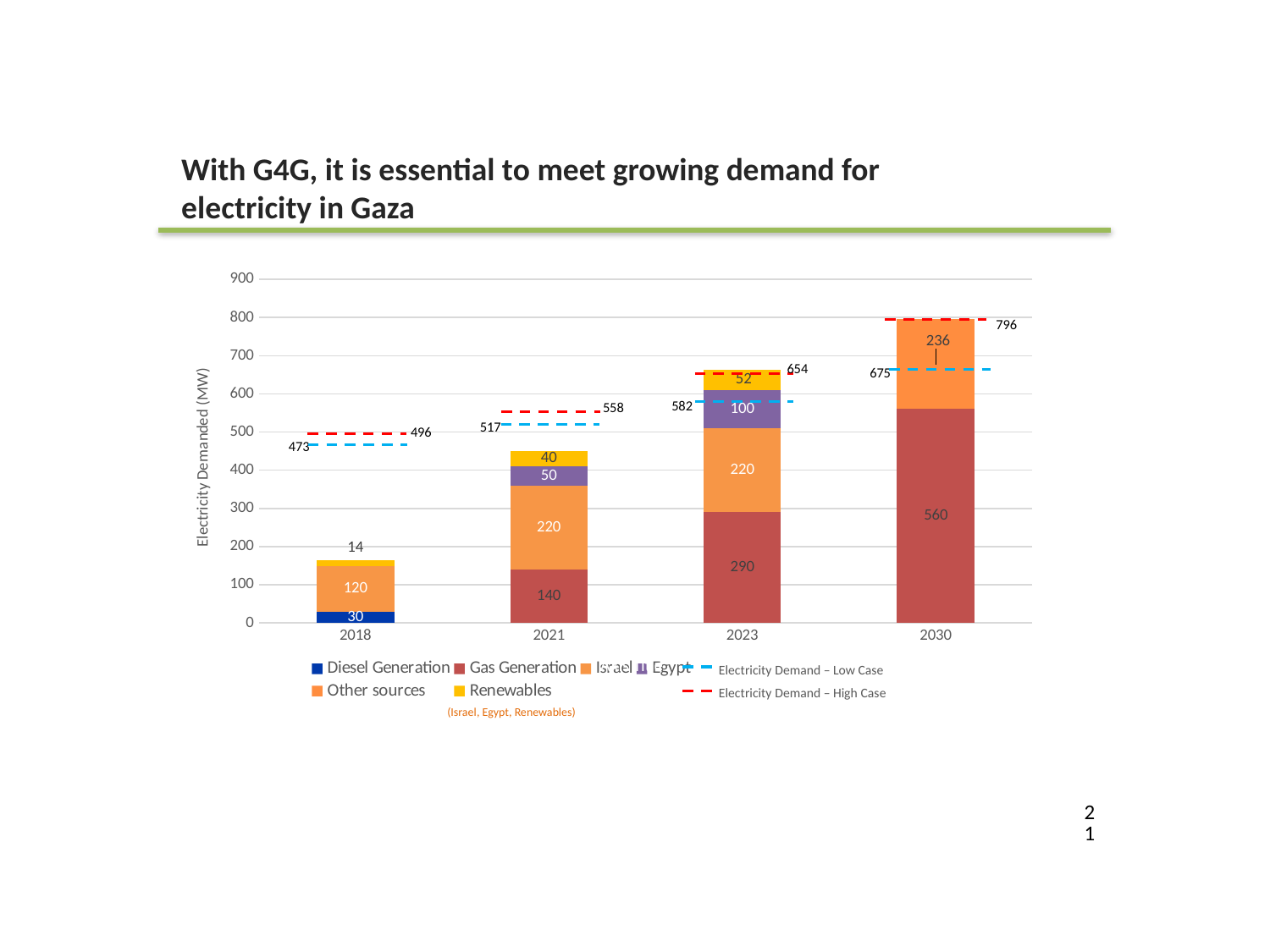
Which year has the highest Gas Generation value? 2030 What is the Egypt value for 2023? 100 What is the label of the y axis? Electricity Demanded (MW) What is the Diesel Generation value for 2018? 30 What kind of chart is shown on the slide? Stacked bar chart What is the Electricity Demand – High Case value for 2030? 796 What is the difference between the High Case and Low Case electricity demand in 2023? 72 Which is larger, the Gas Generation value for 2023 or for 2021? 2023 What is the total height of the stacked bar for 2021? 450 What is the Gas Generation value for 2030? 560 What is the Electricity Demand – Low Case value for 2018? 473 How many years are shown on the x axis? 4